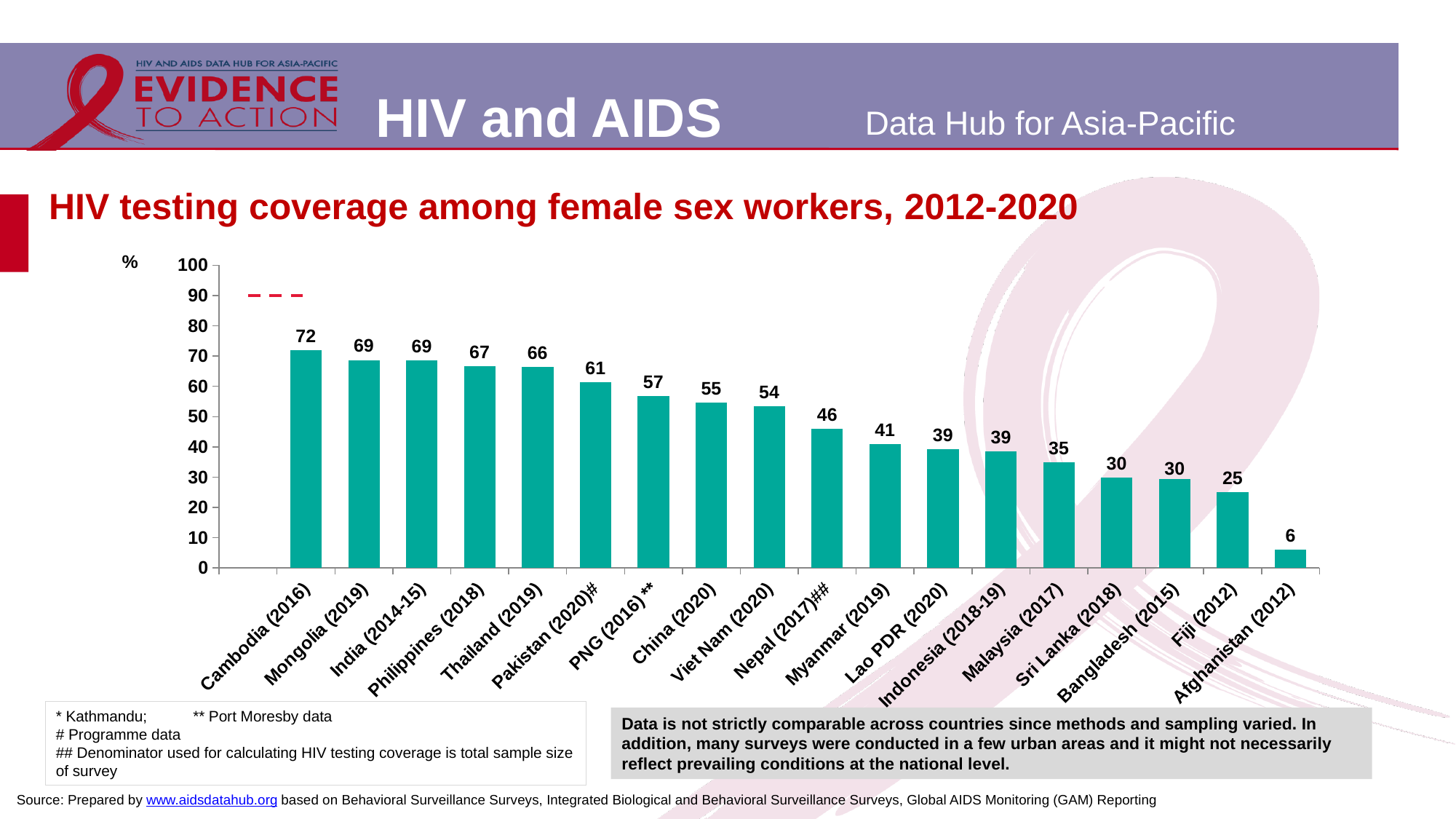
What type of chart is used on the slide? bar chart Is the value for Malaysia (2017) greater or less than 40? less What is the value shown for Viet Nam (2020)? 54 What is the difference between the values for Pakistan (2020)# and China (2020)? 6 Which has a higher value, Thailand (2019) or Myanmar (2019)? Thailand (2019) What is the HIV testing coverage value shown for Cambodia (2016)? 72 How many countries are shown in the chart? 18 What is the difference between the values for Cambodia (2016) and Afghanistan (2012)? 66 What is the value shown for Nepal (2017)##? 46 Which country has the highest HIV testing coverage in the chart? Cambodia (2016) Do the values rise or fall from left to right along the x axis? fall Which country has the lowest HIV testing coverage in the chart? Afghanistan (2012)